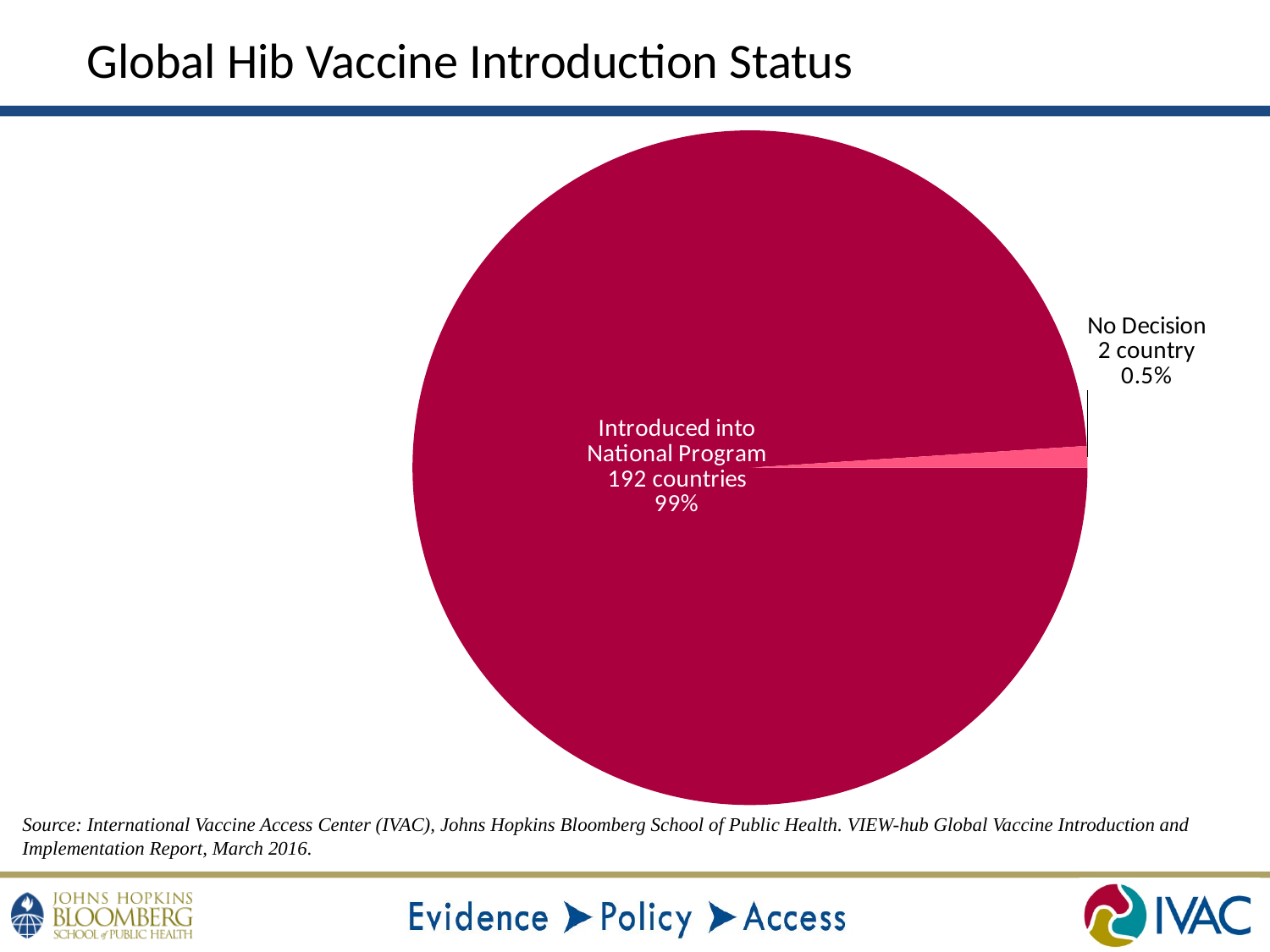
What share of the pie does the Introduced into National Program slice represent? 99% What is the difference in the number of countries between Introduced into National Program and No Decision? 190 Which category has the largest slice of the pie? Introduced into National Program What is the total number of countries represented in the pie chart? 194 Which category has the smallest slice of the pie? No Decision What is the title of the slide? Global Hib Vaccine Introduction Status How many countries are in the No Decision category? 2 How many countries have introduced Hib vaccine into their national program? 192 countries Which has more countries, Introduced into National Program or No Decision? Introduced into National Program How many slices does the pie chart have? 2 What kind of chart is shown on the slide? Pie chart What share of the pie does the No Decision slice represent? 0.5%